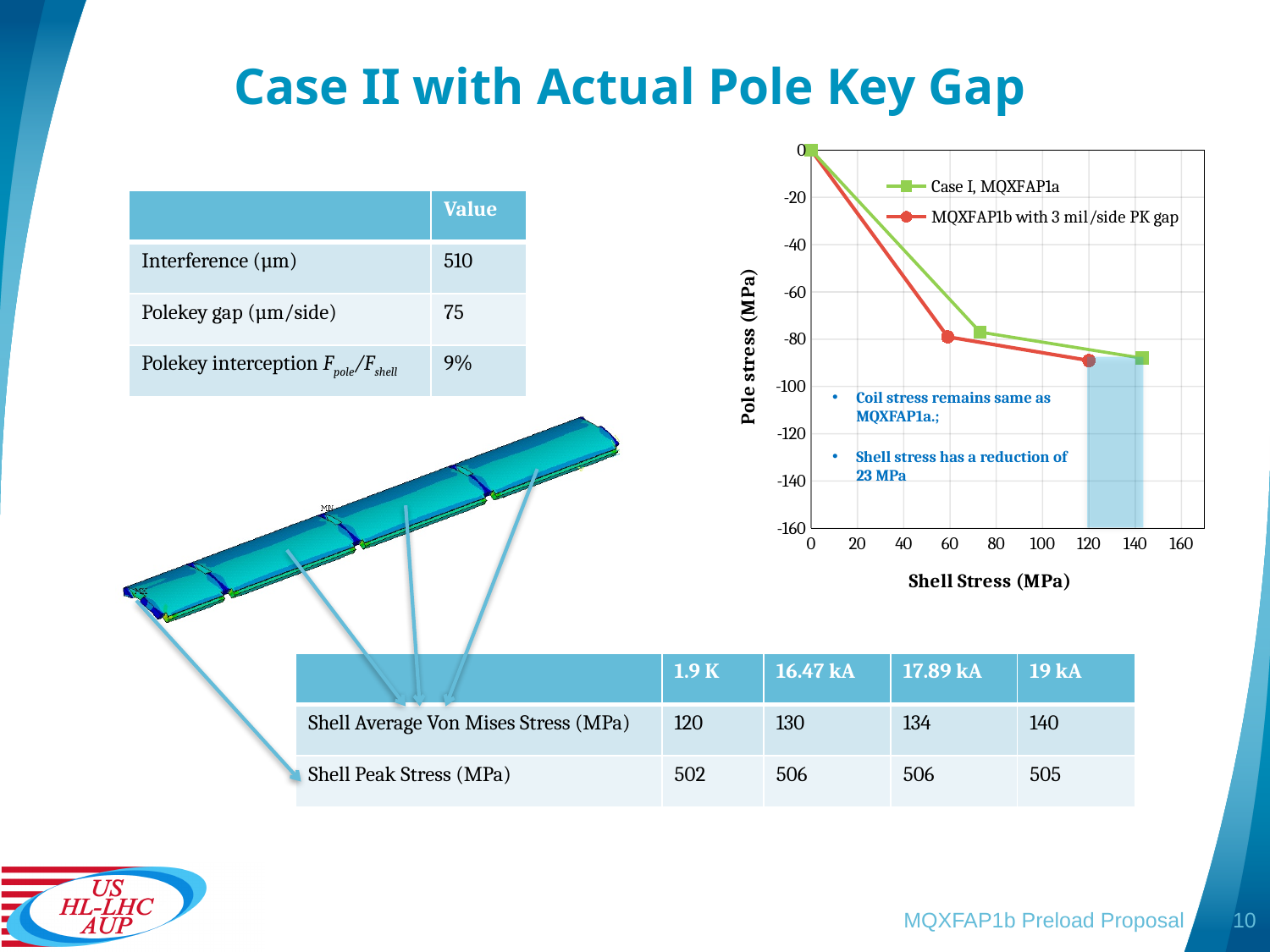
Is the shell stress at the middle point of the Case I, MQXFAP1a series greater or less than 60? greater At their final data points, which series reaches the larger shell stress: Case I, MQXFAP1a or MQXFAP1b with 3 mil/side PK gap? Case I, MQXFAP1a As shell stress increases along the x axis, does the pole stress rise or fall? Fall What are the two series named in the chart legend? Case I, MQXFAP1a; MQXFAP1b with 3 mil/side PK gap What is the title of the chart's x axis? Shell Stress (MPa) How many data points are plotted for the Case I, MQXFAP1a series? 3 Is the pole stress at the last point of the MQXFAP1b with 3 mil/side PK gap series greater or less than -80? less How many data points are plotted for the MQXFAP1b with 3 mil/side PK gap series? 3 How many series does the chart legend list? 2 At their middle data points, which series has the larger shell stress: Case I, MQXFAP1a or MQXFAP1b with 3 mil/side PK gap? Case I, MQXFAP1a What kind of chart is shown on the slide? Line chart Is the pole stress at the last point of the Case I, MQXFAP1a series greater or less than -100? greater